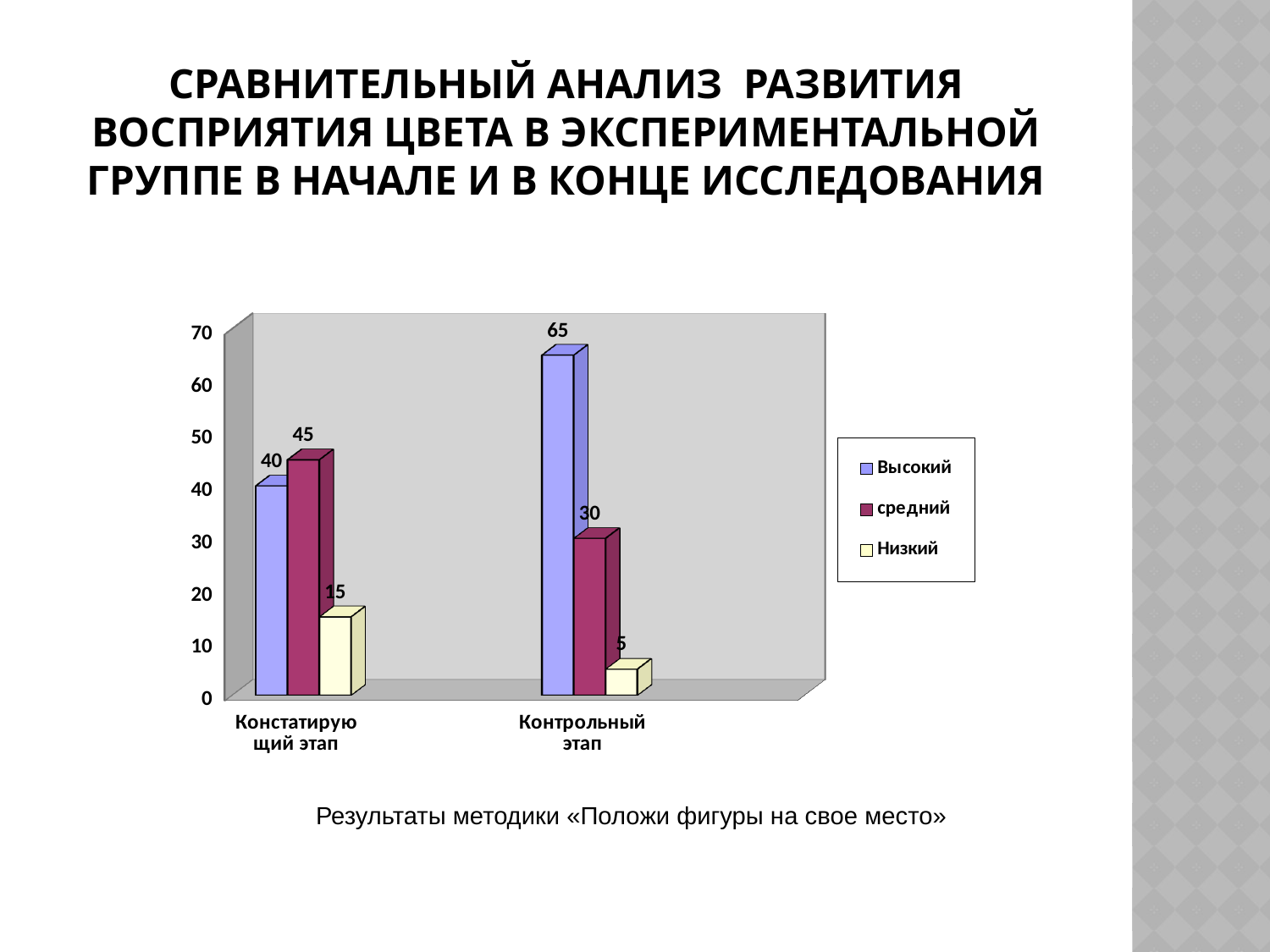
Which series has the lowest value at the Констатирующий этап? Низкий How many series does the legend list? 3 Which is larger: средний at the Констатирующий этап or средний at the Контрольный этап? Констатирующий этап What is the value for Высокий at the Констатирующий этап? 40 How many categories are shown on the x axis? 2 What is the difference between the Высокий values at the Контрольный этап and the Констатирующий этап? 25 Which series has the highest value at the Контрольный этап? Высокий What kind of chart is shown on the slide? bar chart What is the value for Низкий at the Контрольный этап? 5 What is the caption below the chart? Результаты методики «Положи фигуры на свое место» What is the value for средний at the Контрольный этап? 30 Is the value for Высокий at the Контрольный этап greater or less than 60? greater